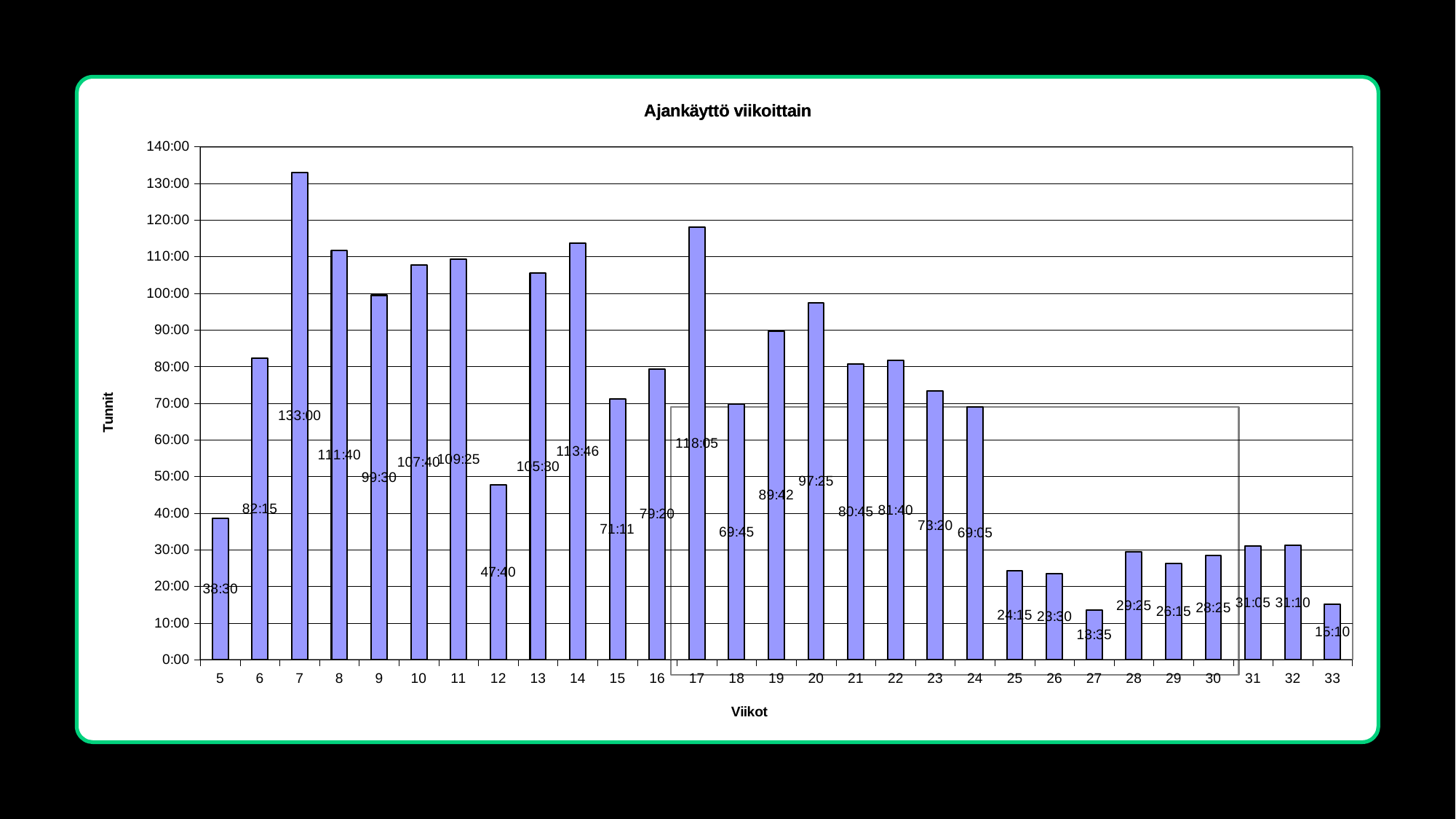
Which week has the lowest value? 27 What is the difference between the values for week 7 and week 8? 21:20 Is the value for week 12 greater or less than 50:00? less How many weeks are shown on the x axis? 29 What is the value for week 7? 133:00 What type of chart is shown on the slide? bar chart What is the value for week 27? 13:35 Which week has the highest value? 7 What is the title of the chart? Ajankäyttö viikoittain What is the label of the vertical axis? Tunnit Which is larger, the value for week 13 or week 14? week 14 What is the value for week 17? 118:05